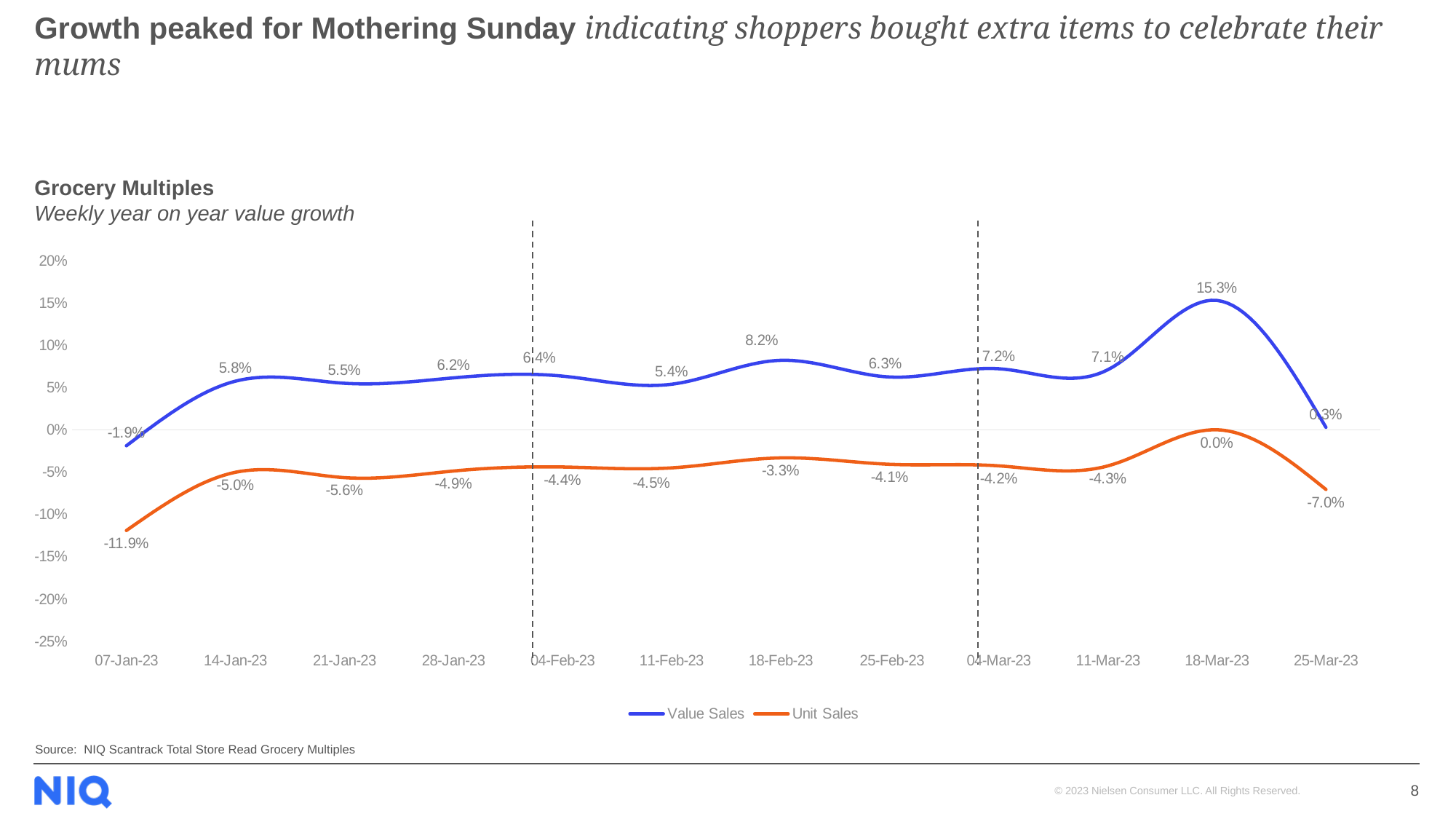
What kind of chart is shown on the slide? Line chart What is the Value Sales growth for the week of 18-Feb-23? 8.2% In which week is Value Sales growth highest? 18-Mar-23 What is the Value Sales growth for the week of 18-Mar-23? 15.3% What is the difference between Value Sales growth and Unit Sales growth in the week of 18-Feb-23? 11.5 percentage points What is the Unit Sales growth for the week of 07-Jan-23? -11.9% In which week is Unit Sales growth lowest? 07-Jan-23 Which is larger, Value Sales growth on 14-Jan-23 or on 28-Jan-23? 28-Jan-23 Which series is drawn in orange? Unit Sales How many series does the legend list? 2 What is the Unit Sales growth for the week of 21-Jan-23? -5.6% How many weekly data points are plotted along the x axis? 12